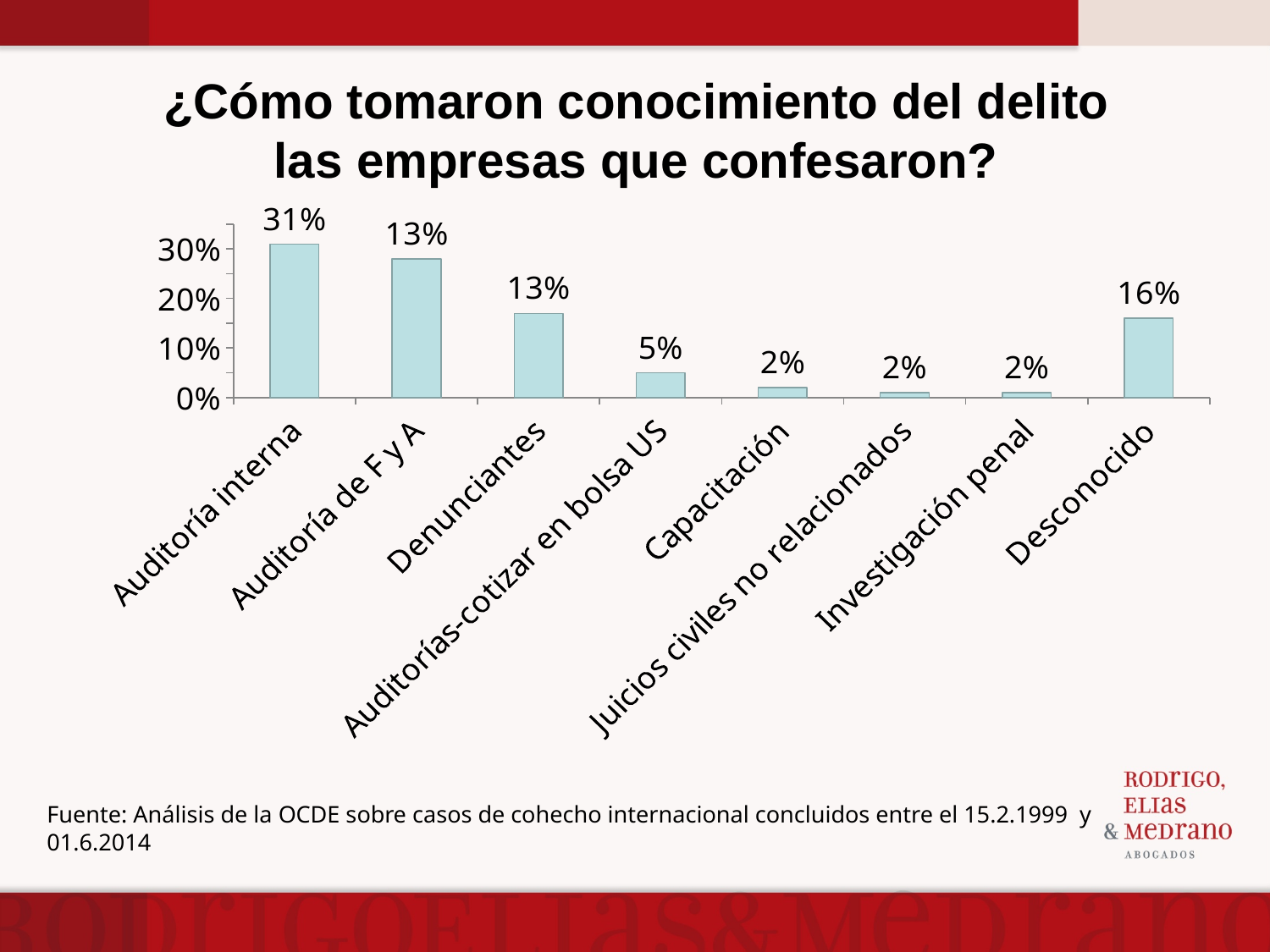
What is the value for Investigación penal? 2% Which is larger, the value for Desconocido or the value for Denunciantes? Desconocido What is the value for Auditorías-cotizar en bolsa US? 5% How many categories are shown on the x axis? 8 Is the value for Capacitación greater or less than 10%? less What is the difference between the values for Auditoría interna and Desconocido? 15 percentage points What is the title of the chart? ¿Cómo tomaron conocimiento del delito las empresas que confesaron? What is the value for Auditoría interna? 31% What is the value for Desconocido? 16% What is the value for Denunciantes? 13% What kind of chart is shown on the slide? bar chart Which category has the highest value? Auditoría interna